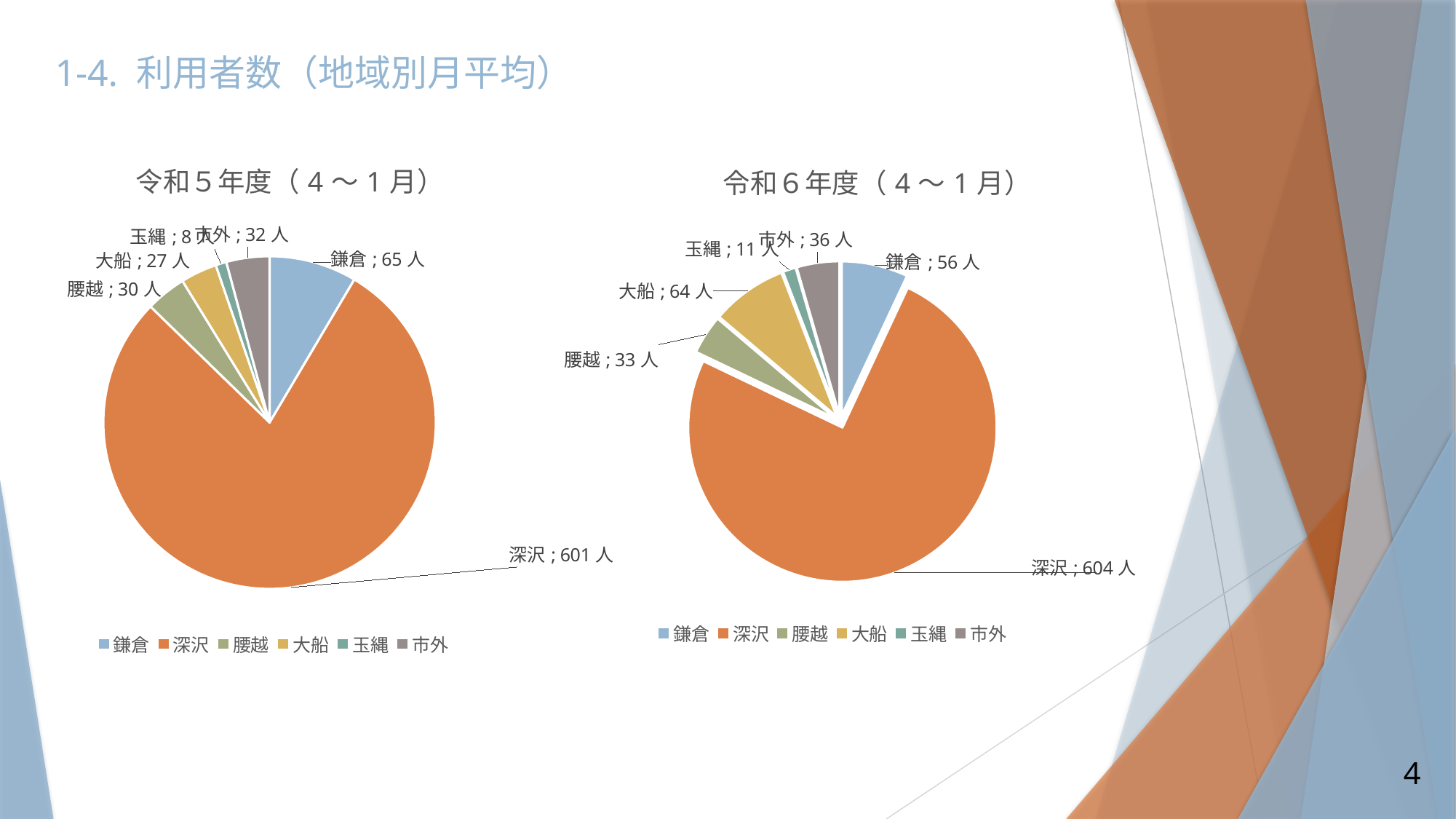
In the 令和５年度（４～１月） chart, what is the value for 深沢? 601 人 In the 令和６年度（４～１月） chart, what is the value for 市外? 36 人 What kind of chart is the 令和５年度（４～１月） chart? pie chart In the 令和５年度（４～１月） chart, which category has the smallest slice? 玉縄 What is the title of the chart on the right of the slide? 令和６年度（４～１月） In the 令和５年度（４～１月） chart, what is the difference between 鎌倉 and 市外? 33 人 In the 令和５年度（４～１月） chart, what is the value for 玉縄? 8 人 In the 令和６年度（４～１月） chart, what is the difference between 大船 and 腰越? 31 人 In the 令和６年度（４～１月） chart, which is larger, 鎌倉 or 大船? 大船 How many categories does the 令和５年度（４～１月） chart show? 6 In the 令和６年度（４～１月） chart, what is the value for 大船? 64 人 In the 令和６年度（４～１月） chart, which category has the largest slice? 深沢